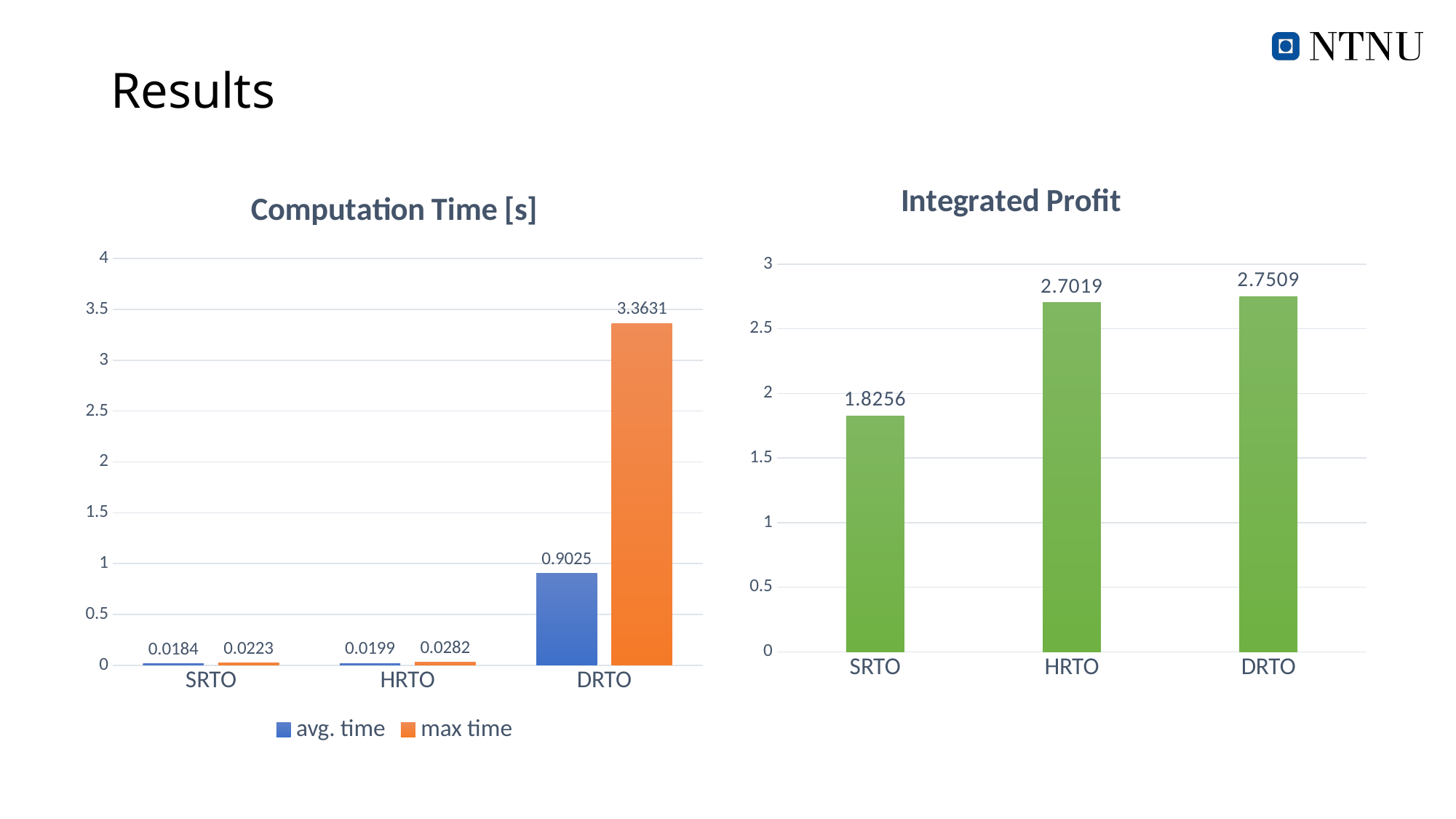
In the Integrated Profit chart, what is the value for SRTO? 1.8256 What kind of chart is the Integrated Profit chart? bar chart In the Integrated Profit chart, how many categories are shown? 3 In the Computation Time [s] chart, which category has the highest avg. time? DRTO In the Integrated Profit chart, which category has the lowest value? SRTO In the Computation Time [s] chart, how many series does the legend list? 2 In the Computation Time [s] chart, is the max time for DRTO greater or less than 3? greater In the Computation Time [s] chart, what is the max time for HRTO? 0.0282 In the Computation Time [s] chart, what is the max time for DRTO? 3.3631 In the Integrated Profit chart, what is the value for HRTO? 2.7019 In the Computation Time [s] chart, what is the avg. time for SRTO? 0.0184 In the Computation Time [s] chart, what is the difference between the max time and avg. time for DRTO? 2.4606